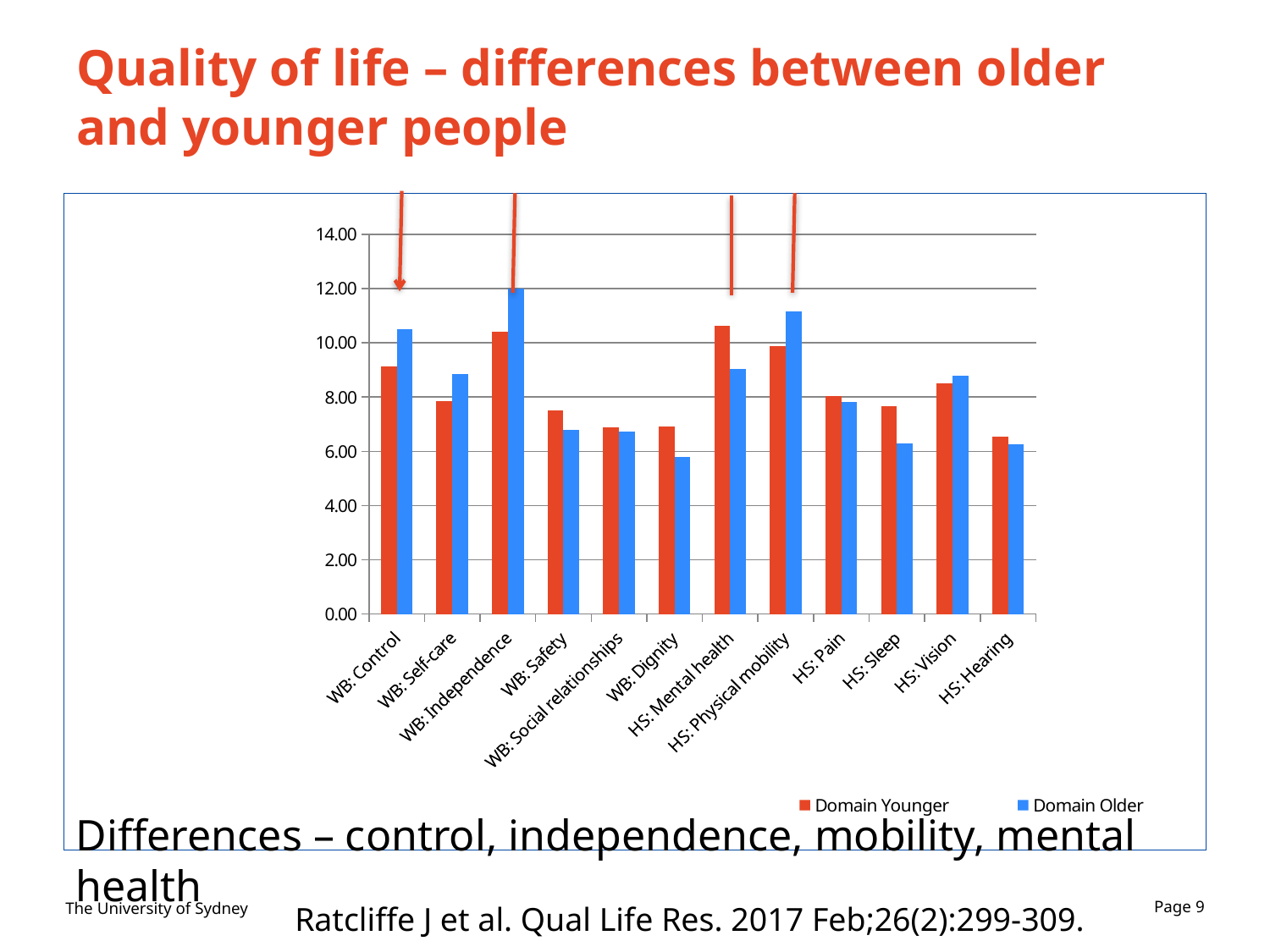
For WB: Control, which series has the larger value, Domain Younger or Domain Older? Domain Older How many series does the legend list? 2 Is the Domain Younger value for HS: Mental health greater or less than 10.00? greater Which colour represents the Domain Older series in the chart? blue Is the Domain Older value for HS: Physical mobility greater or less than 10.00? greater Is the Domain Older value for WB: Dignity greater or less than 6.00? less How many categories are shown on the x axis? 12 Which category has the lowest value for Domain Older? WB: Dignity What kind of chart is shown on the slide? bar chart For HS: Mental health, which series has the larger value, Domain Younger or Domain Older? Domain Younger Which category has the highest value for Domain Older? WB: Independence